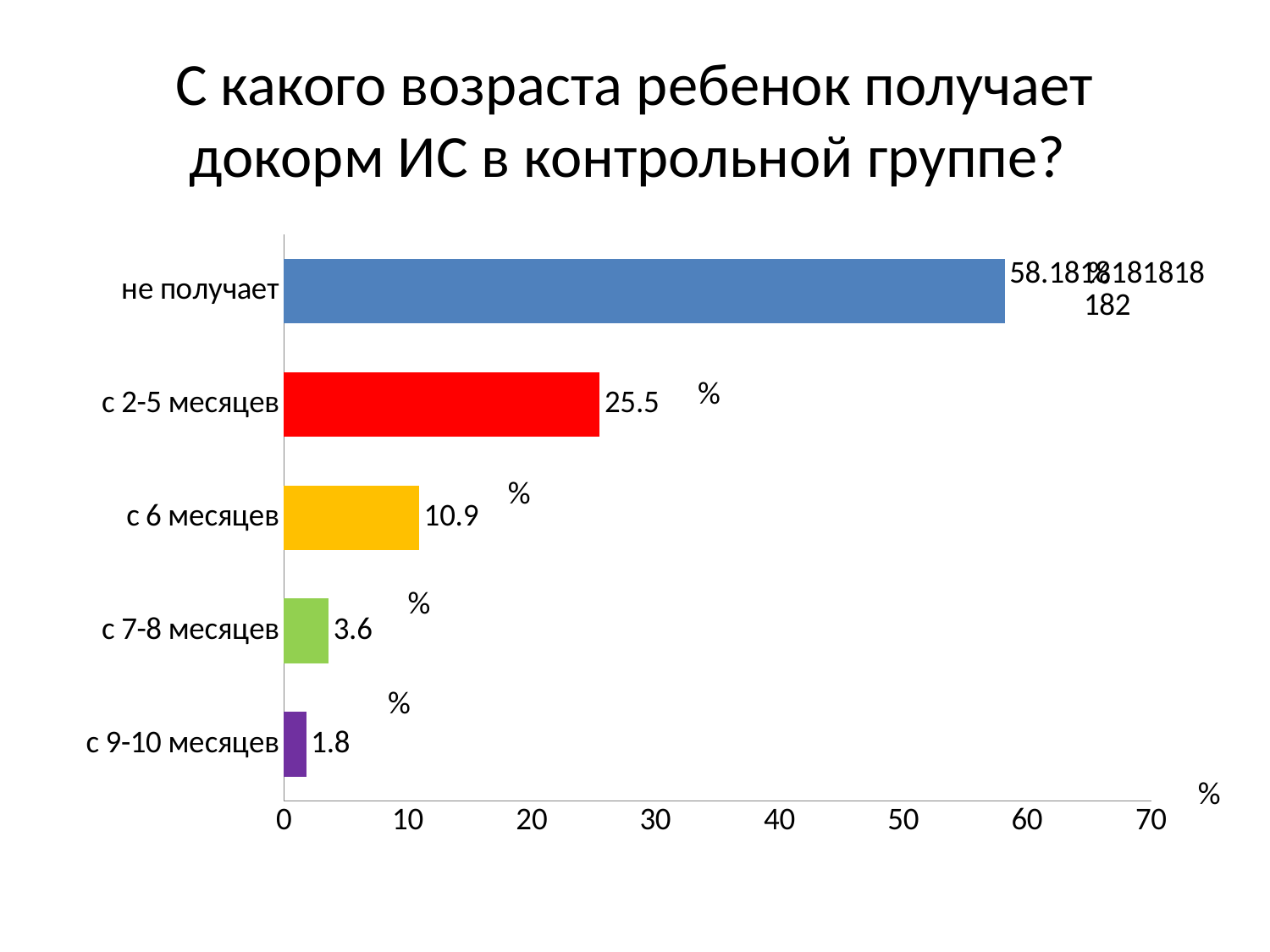
Which category has the highest value? не получает Which is larger, the value for "с 6 месяцев" or the value for "с 7-8 месяцев"? с 6 месяцев What is the difference between the values for "с 2-5 месяцев" and "с 6 месяцев"? 14.6 What is the title of the chart on the slide? С какого возраста ребенок получает докорм ИС в контрольной группе? What is the value for "с 9-10 месяцев"? 1.8 What type of chart is shown on the slide? bar chart Which category has the lowest value? с 9-10 месяцев What is the value for "с 6 месяцев"? 10.9 What is the value for "с 2-5 месяцев"? 25.5 How many categories are shown in the chart? 5 What is the value for "с 7-8 месяцев"? 3.6 Is the value for "не получает" greater or less than 50? greater